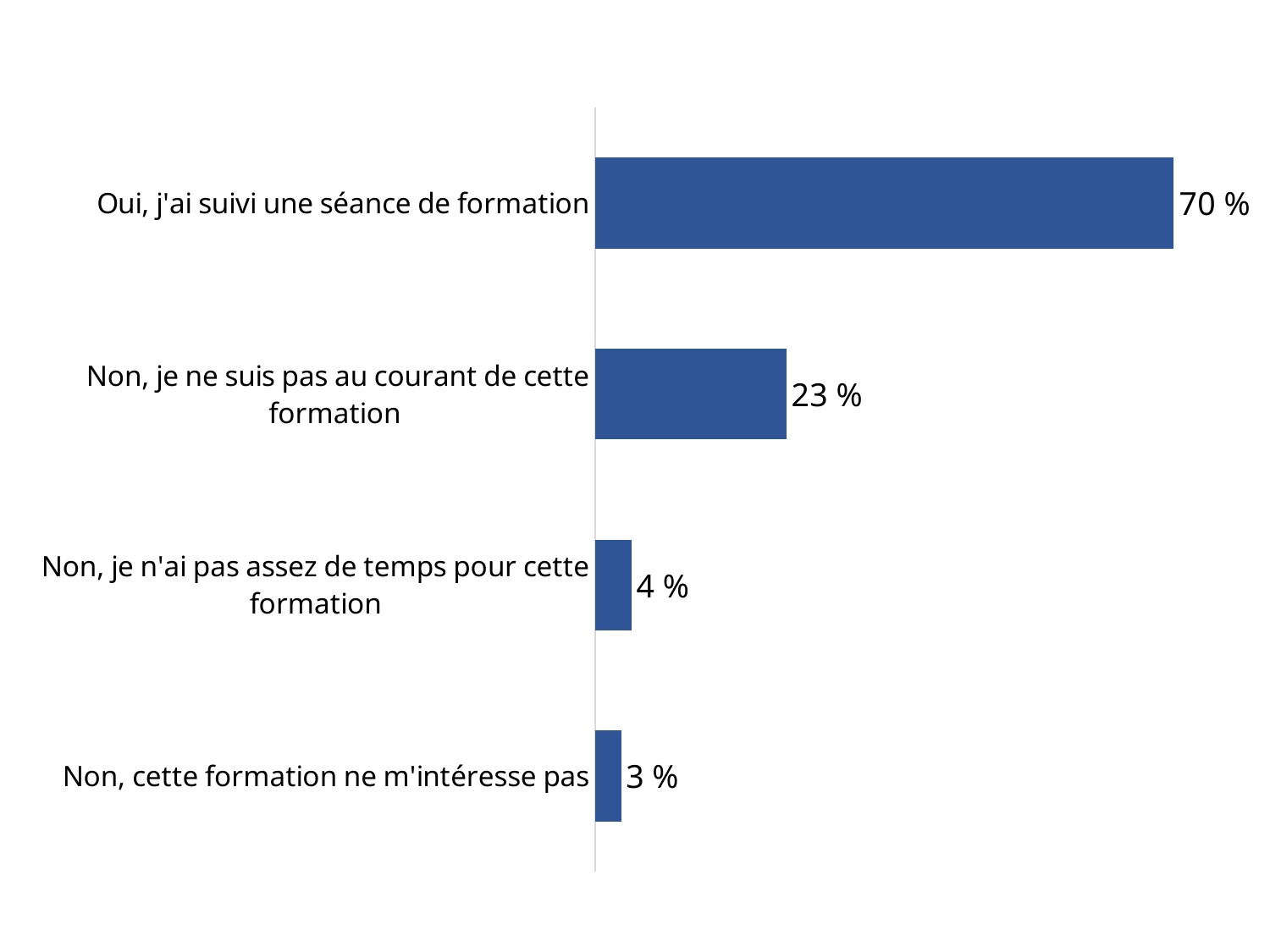
Which category has the lowest value? Non, cette formation ne m'intéresse pas What is the value for "Non, je n'ai pas assez de temps pour cette formation"? 4 % What is the value for "Non, cette formation ne m'intéresse pas"? 3 % Which is larger: the value for "Non, je ne suis pas au courant de cette formation" or the value for "Non, je n'ai pas assez de temps pour cette formation"? Non, je ne suis pas au courant de cette formation What is the difference between the values for "Oui, j'ai suivi une séance de formation" and "Non, je ne suis pas au courant de cette formation"? 47 % What is the value for "Non, je ne suis pas au courant de cette formation"? 23 % Which category has the highest value? Oui, j'ai suivi une séance de formation What colour are the bars in the chart? Blue What kind of chart is shown on the slide? Bar chart What is the difference between the values for "Non, je n'ai pas assez de temps pour cette formation" and "Non, cette formation ne m'intéresse pas"? 1 % What is the value for "Oui, j'ai suivi une séance de formation"? 70 % How many categories are shown in the chart? 4